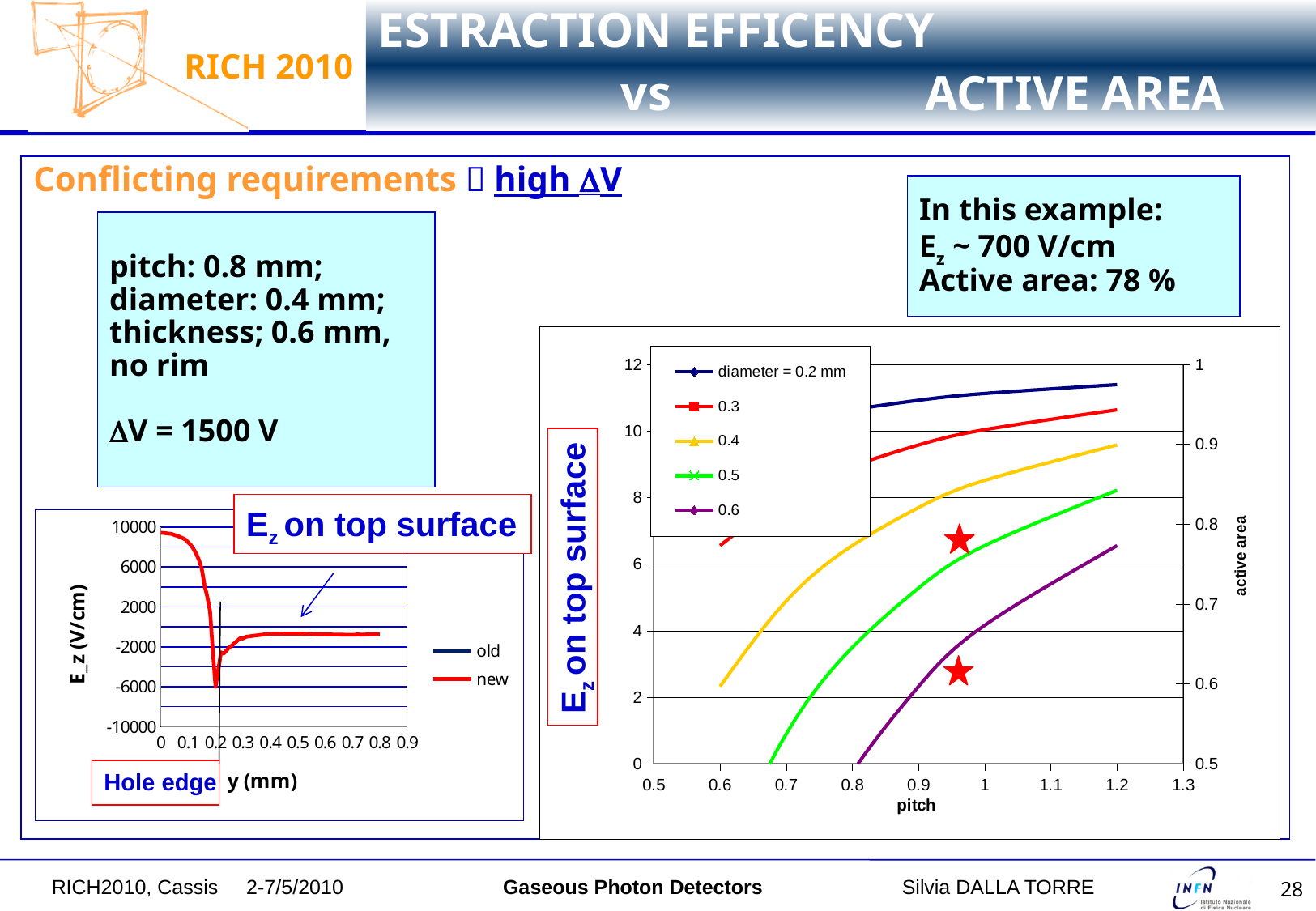
On the right chart (Ez on top surface vs pitch), is the value for the 0.4 series at pitch 0.6 greater or less than 4? less On the right chart (Ez on top surface vs pitch), which is larger at pitch 1.0: the 0.3 series or the 0.6 series? 0.3 On the right chart (Ez on top surface vs pitch), which series has the lowest value at pitch 1.2? 0.6 On the right chart (Ez on top surface vs pitch), is the value for the diameter = 0.2 mm series at pitch 1.2 greater or less than 10? greater On the left chart (Ez on top surface vs y), what is the label of the x axis? y (mm) On the left chart (Ez on top surface vs y), how many series does the legend list? 2 On the right chart (Ez on top surface vs pitch), what kind of chart is it? line chart On the right chart (Ez on top surface vs pitch), how many series does the legend list? 5 On the right chart (Ez on top surface vs pitch), what is the label of the right-hand vertical axis? active area On the right chart (Ez on top surface vs pitch), which series has the highest value at pitch 1.2? diameter = 0.2 mm On the right chart (Ez on top surface vs pitch), do the values of each series rise or fall as pitch increases? rise On the right chart (Ez on top surface vs pitch), is the value for the 0.5 series at pitch 1.2 greater or less than 6? greater